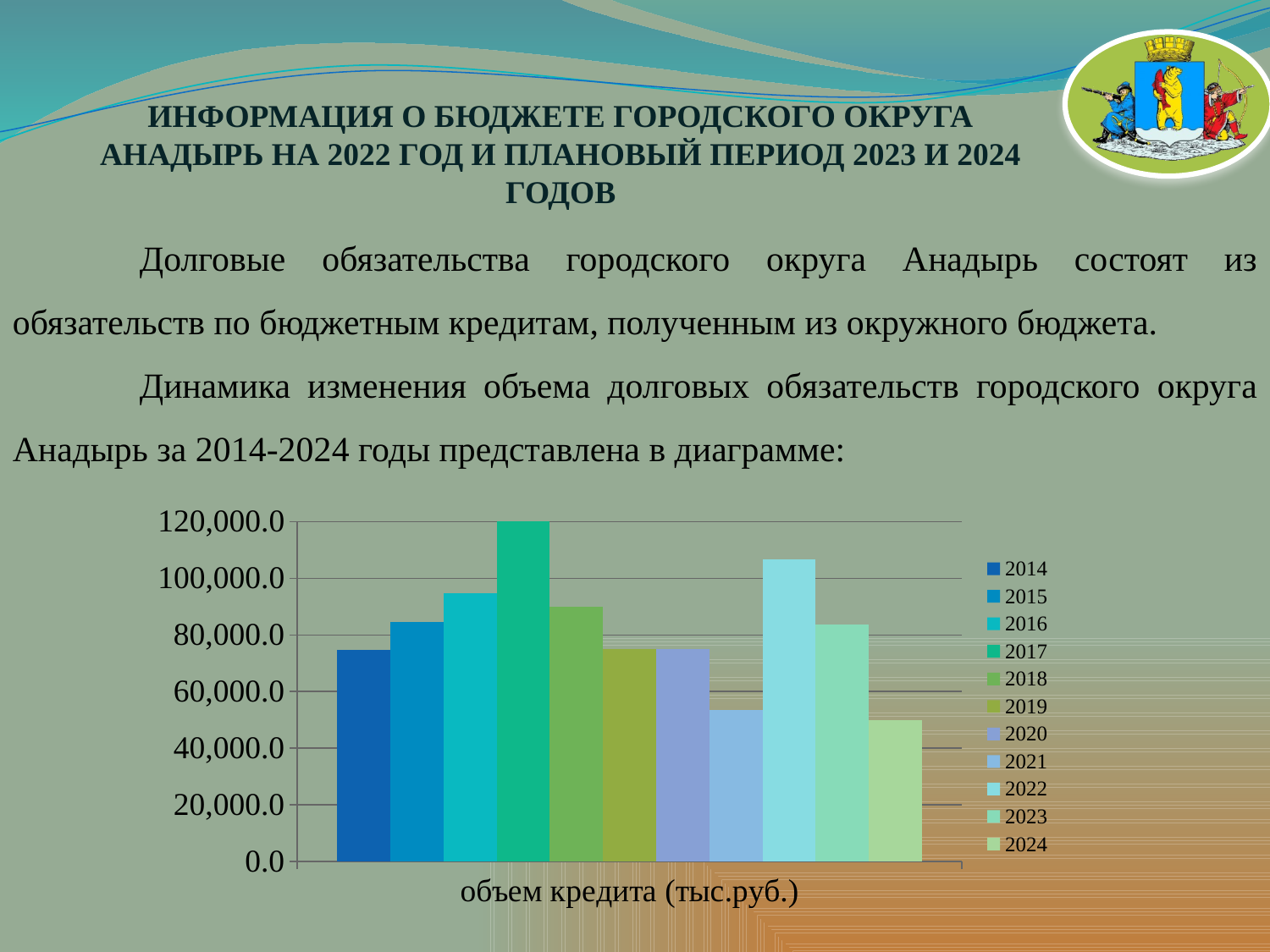
How many series does the legend list? 11 What kind of chart is shown on the slide? bar chart Is the value for 2014 greater or less than 60,000.0? greater Which is larger, the value for 2017 or the value for 2022? 2017 What is the value for 2017? 120,000.0 Which year has the highest value in the chart? 2017 Is the value for 2021 greater or less than 60,000.0? less Is the value for 2022 greater or less than 100,000.0? greater Which is larger, the value for 2018 or the value for 2019? 2018 What is the label shown under the bars on the x axis? объем кредита (тыс.руб.)